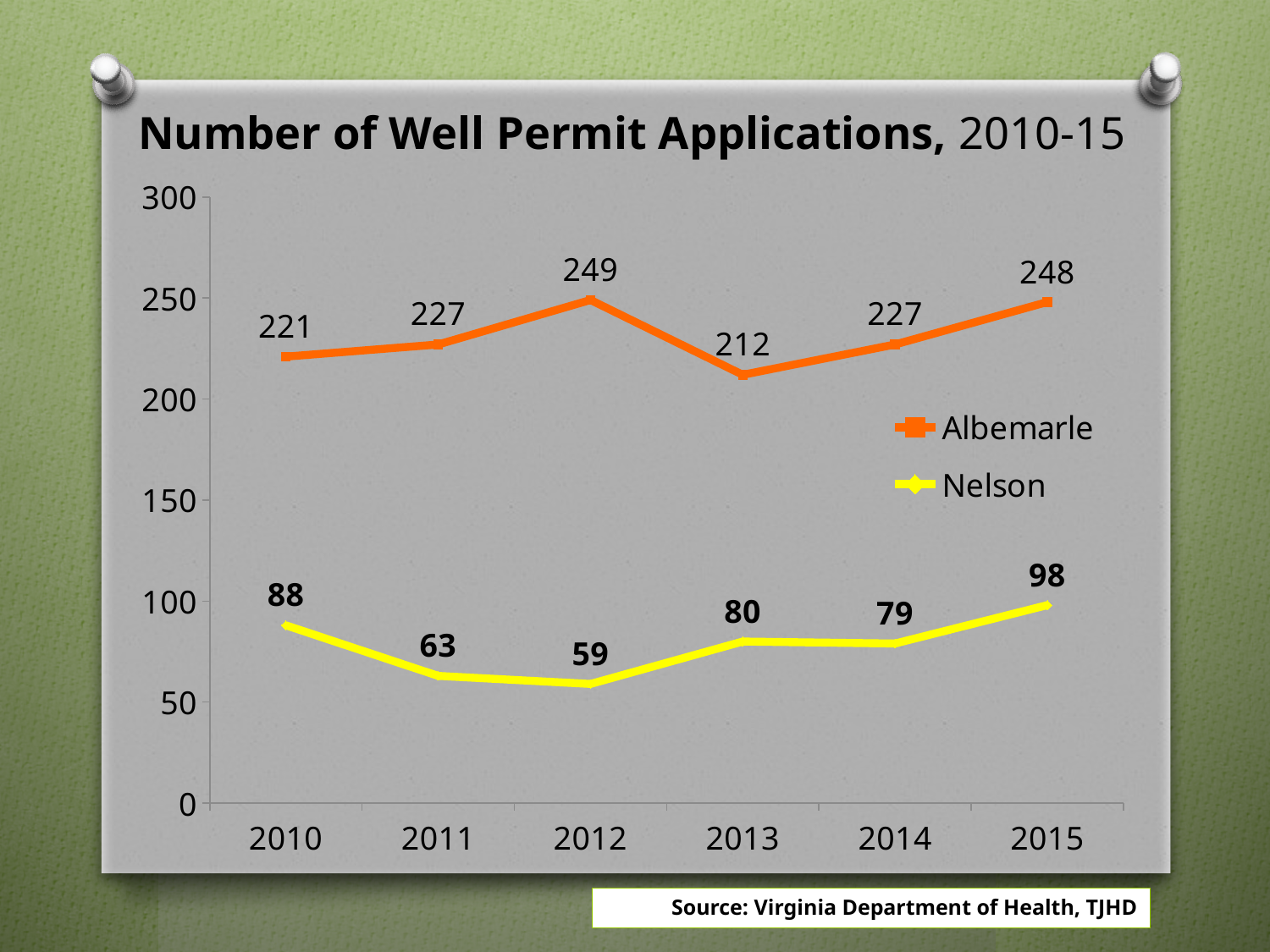
How many series does the legend list? 2 In which year did Nelson have the highest number of well permit applications? 2015 What kind of chart is shown on the slide? Line chart What was the number of well permit applications for Nelson in 2015? 98 In which year did Nelson have the lowest number of well permit applications? 2012 What is the difference between Albemarle's and Nelson's well permit applications in 2010? 133 How many years are shown on the x axis of the chart? 6 In which year did Albemarle have the lowest number of well permit applications? 2013 Did Nelson's well permit applications rise or fall from 2012 to 2015? Rise What was the number of well permit applications for Albemarle in 2012? 249 How much did Nelson's well permit applications increase from 2014 to 2015? 19 Which county had more well permit applications in 2013, Albemarle or Nelson? Albemarle